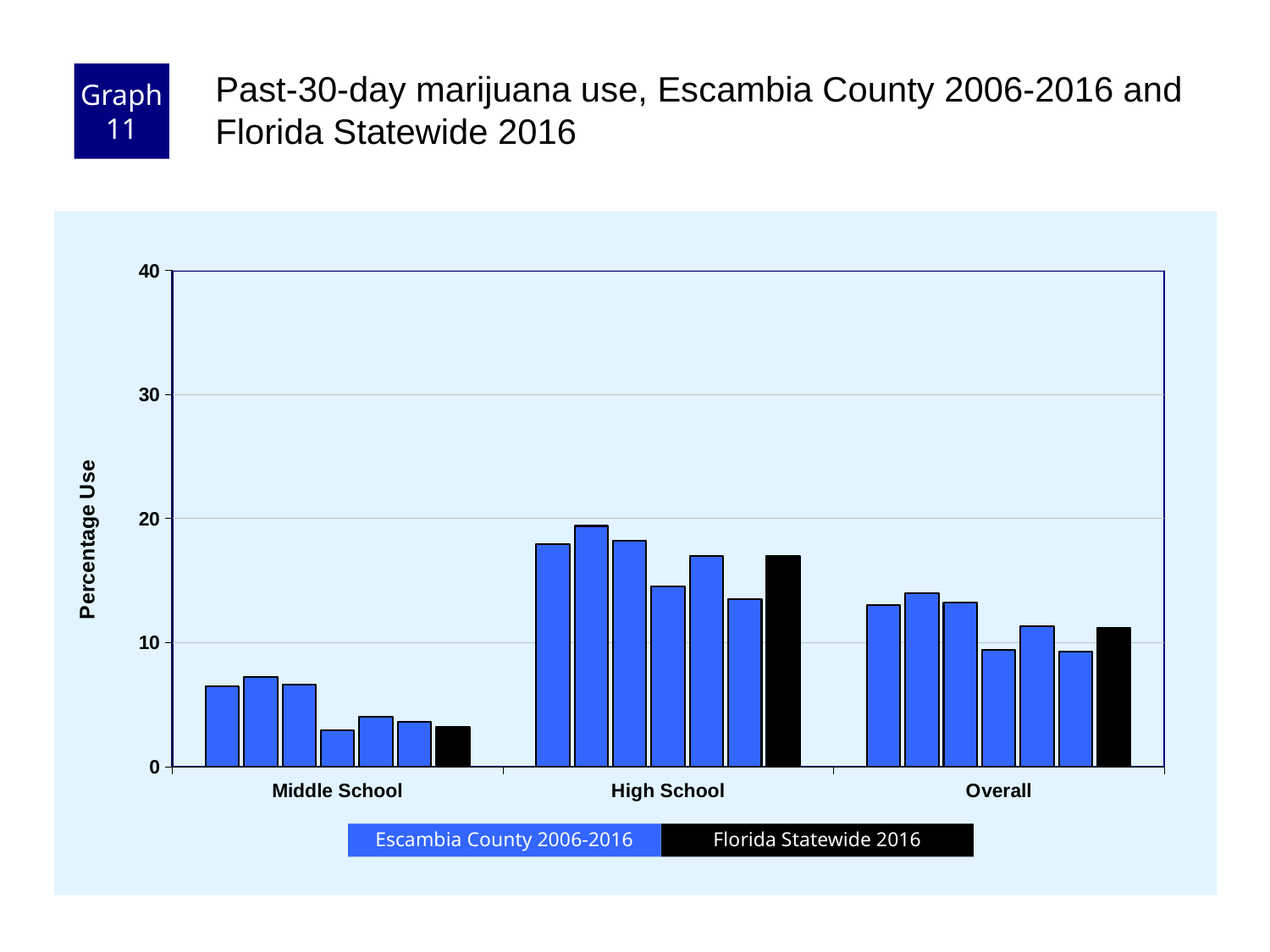
Is the Florida Statewide 2016 value for Middle School greater or less than 10? less Which category has the highest Florida Statewide 2016 value? High School What kind of chart is shown on the slide? bar chart What is the label on the y axis? Percentage Use Is the Florida Statewide 2016 value for High School greater or less than 10? greater Is the Florida Statewide 2016 value for High School greater or less than 20? less Which is larger, the Florida Statewide 2016 value for High School or for Overall? High School How many categories are shown on the x axis? 3 How many series does the legend list? 2 Which category has the lowest Florida Statewide 2016 value? Middle School What are the two series named in the legend? Escambia County 2006-2016 and Florida Statewide 2016